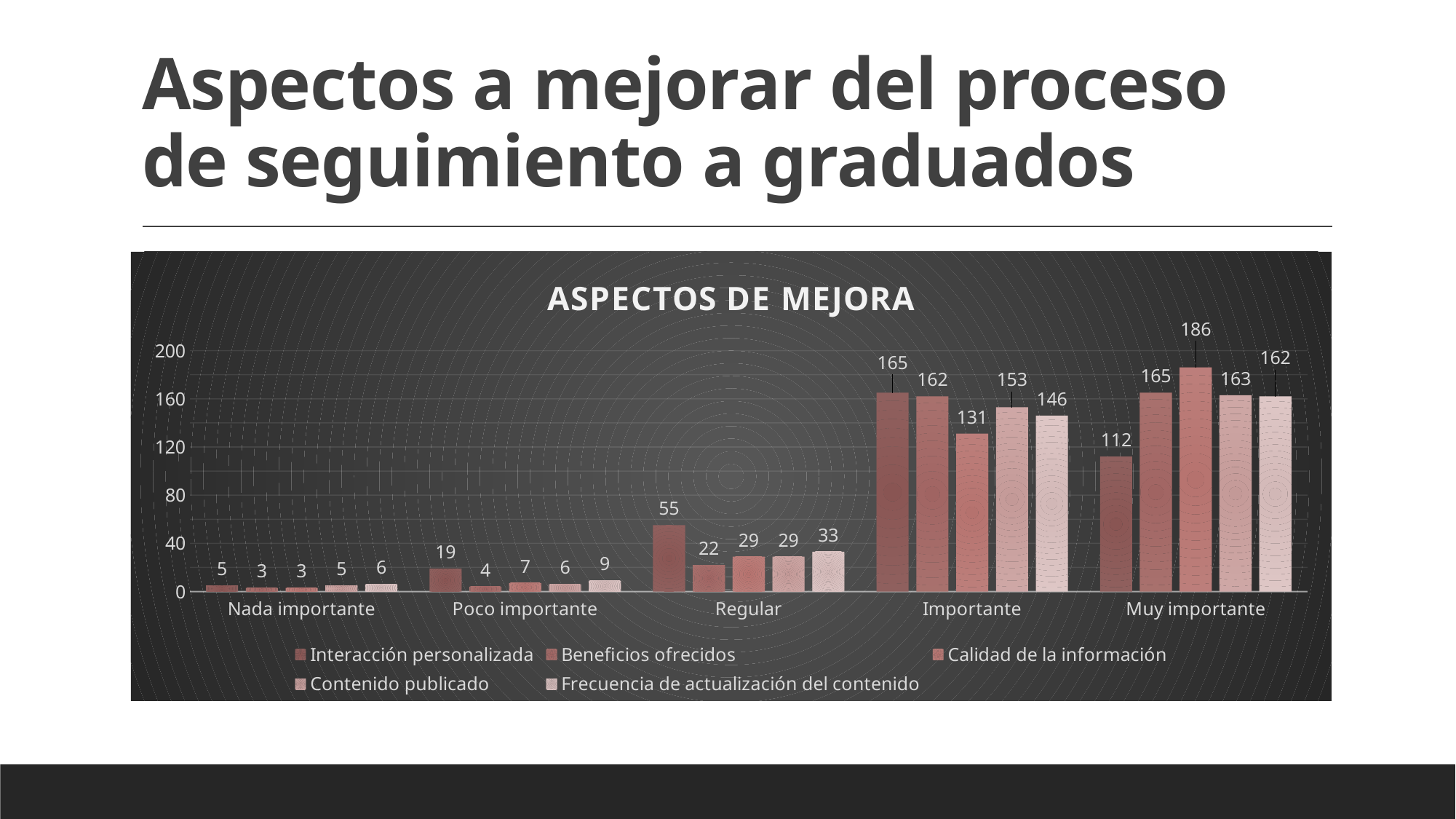
Which series has the highest value in the Muy importante category? Calidad de la información What kind of chart is shown on the slide? Bar chart Which is larger in the Muy importante category: Interacción personalizada or Beneficios ofrecidos? Beneficios ofrecidos Which series has the lowest value in the Importante category? Calidad de la información What is the title of the chart? ASPECTOS DE MEJORA What is the value for Interacción personalizada in the Regular category? 55 What is the value for Contenido publicado in the Importante category? 153 What is the difference between Interacción personalizada and Calidad de la información in the Importante category? 34 How many series does the legend list? 5 What is the value for Calidad de la información in the Muy importante category? 186 How many categories are shown on the x axis? 5 What is the value for Frecuencia de actualización del contenido in the Poco importante category? 9